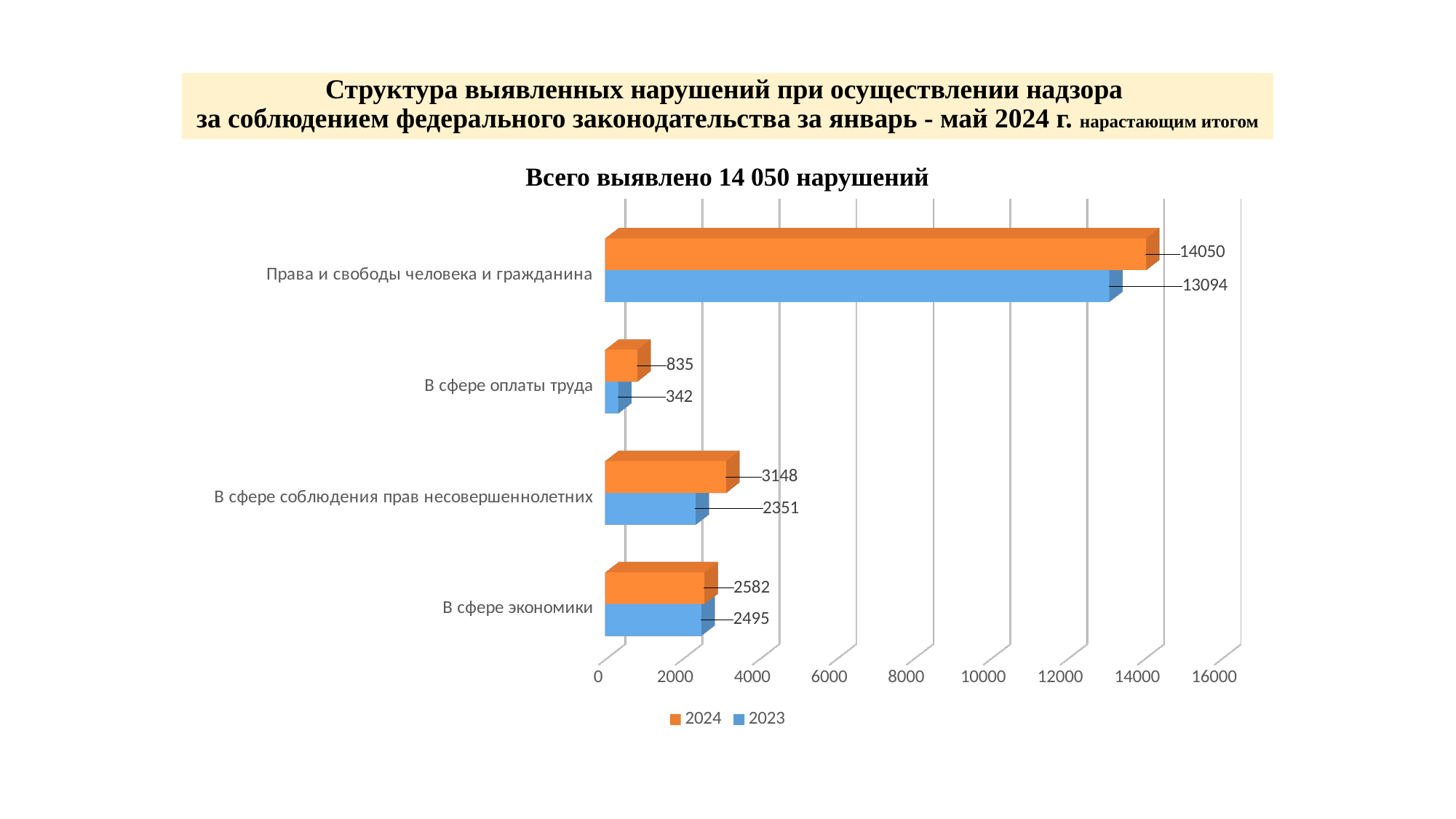
Which category has the highest 2024 value? Права и свободы человека и гражданина How many categories are shown on the chart? 4 What is the 2024 value for «Права и свободы человека и гражданина»? 14050 What kind of chart is shown on the slide? Bar chart Which colour represents the 2023 series? Blue What is the 2024 value for «В сфере соблюдения прав несовершеннолетних»? 3148 Which is larger for «В сфере экономики»: the 2024 value or the 2023 value? 2024 What is the difference between the 2024 and 2023 values for «В сфере оплаты труда»? 493 How many series does the legend list? 2 Which category has the lowest 2023 value? В сфере оплаты труда What is the 2023 value for «В сфере экономики»? 2495 What is the 2023 value for «В сфере оплаты труда»? 342